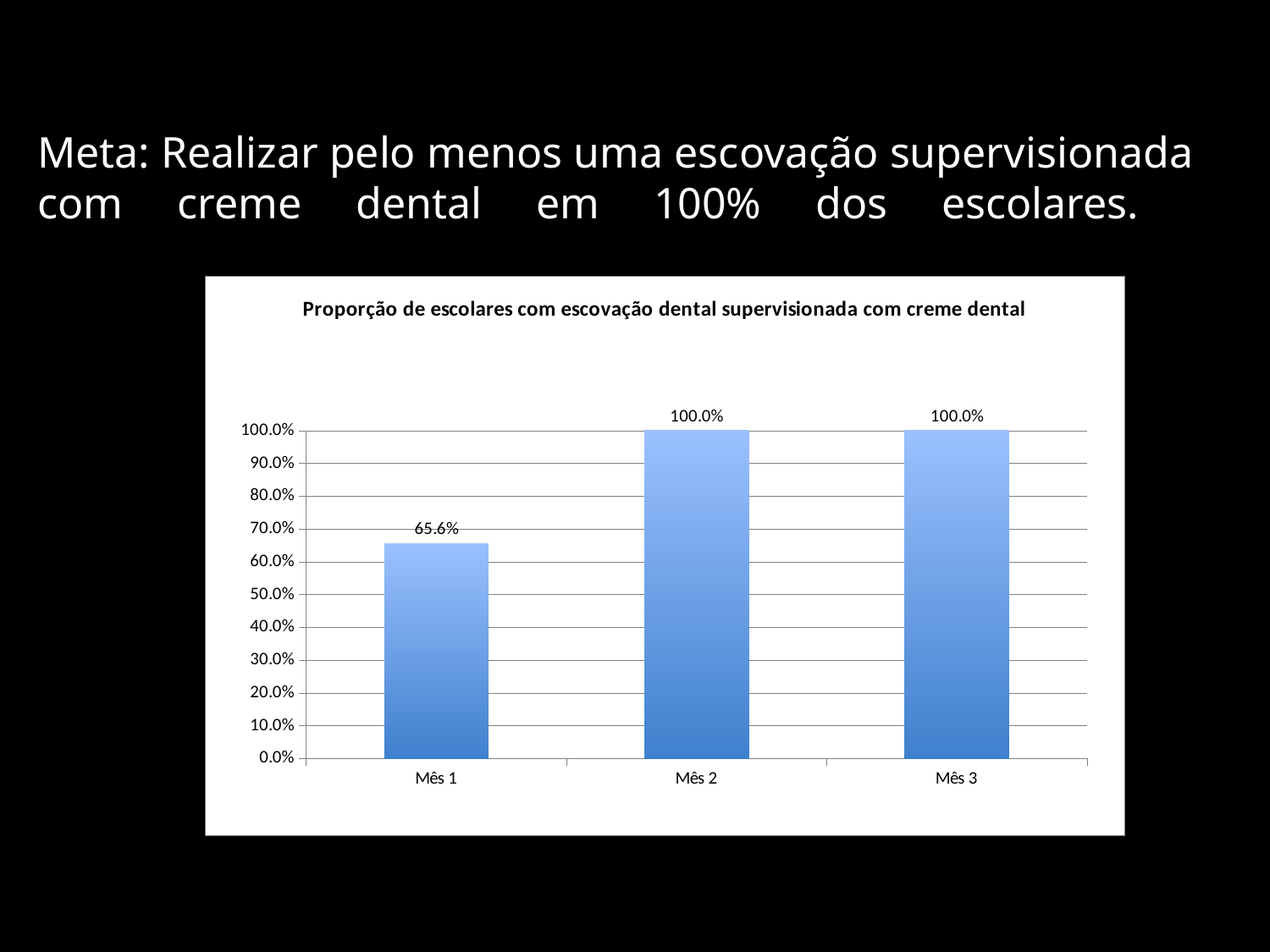
What kind of chart is shown on the slide? Bar chart Which is larger, the value for Mês 1 or the value for Mês 3? Mês 3 What is the title of the chart? Proporção de escolares com escovação dental supervisionada com creme dental What is the difference between the values for Mês 2 and Mês 1? 34.4% What is the value for Mês 2? 100.0% How many categories are shown on the x axis? 3 What is the value for Mês 1? 65.6% Which month has the lowest proportion? Mês 1 What is the highest value shown on the y axis? 100.0% Do the values rise or fall from Mês 1 to Mês 2? Rise What is the value for Mês 3? 100.0% Is the value for Mês 1 greater or less than 70.0%? less